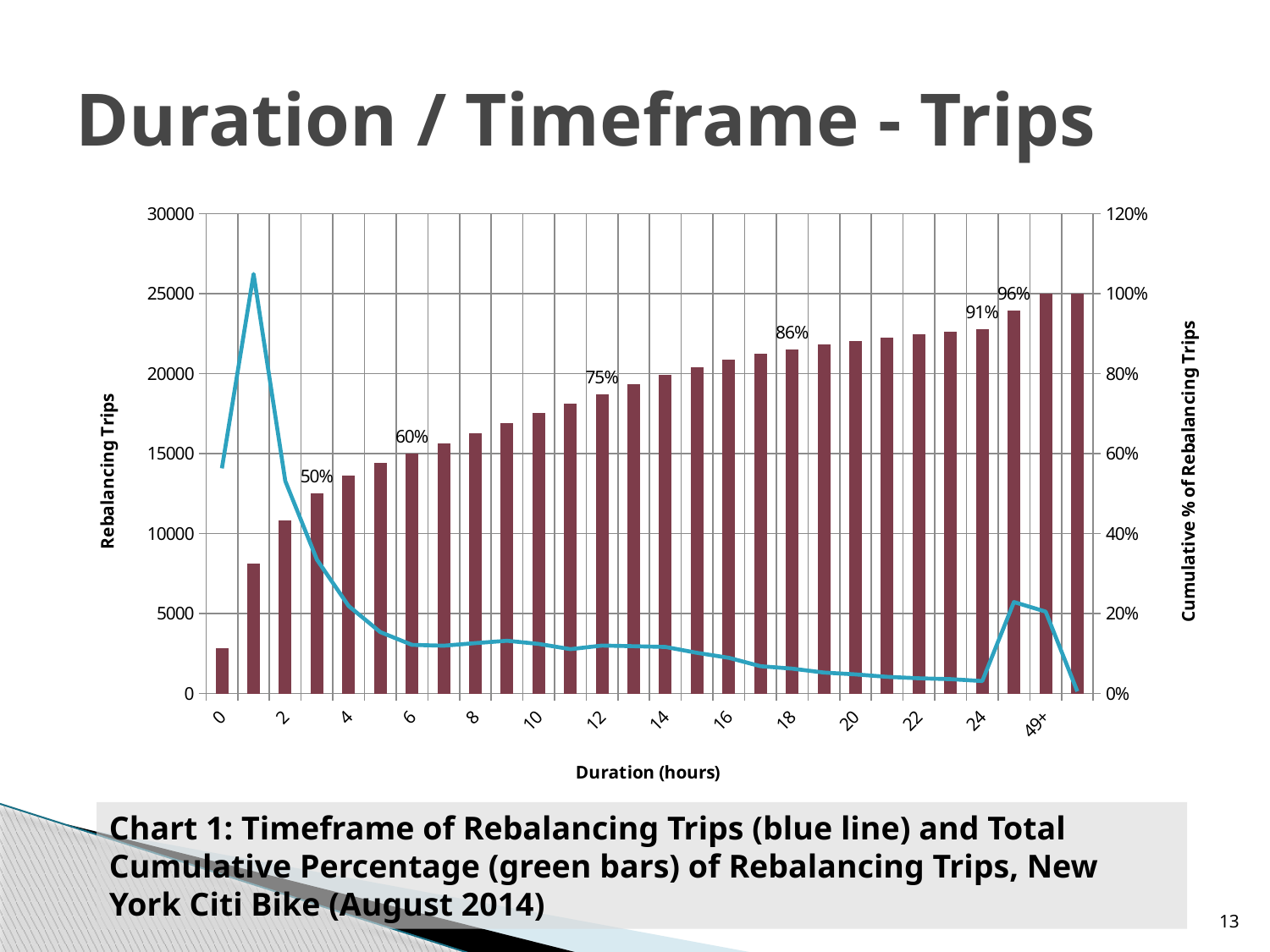
How many percentage data labels are printed on the bars? 6 What is the highest cumulative percentage value printed as a data label on the chart? 96% What is the title of the x axis of the chart? Duration (hours) Which has the larger cumulative percentage label, the bar at 6 hours or the bar at 12 hours? 12 hours What cumulative percentage label is printed on the bar at a duration of 6 hours? 60% What is the difference between the cumulative percentage labels at 18 hours and 12 hours? 11% What cumulative percentage label is printed on the bar at a duration of 18 hours? 86% Is the peak value of the blue Rebalancing Trips line greater or less than 25000? greater Is the value of the blue line at a duration of 0 hours greater or less than 15000? less Do the cumulative percentage bars rise or fall as duration increases along the x axis? rise What cumulative percentage label is printed on the bar at a duration of 24 hours? 91% What cumulative percentage label is printed on the bar at a duration of 12 hours? 75%